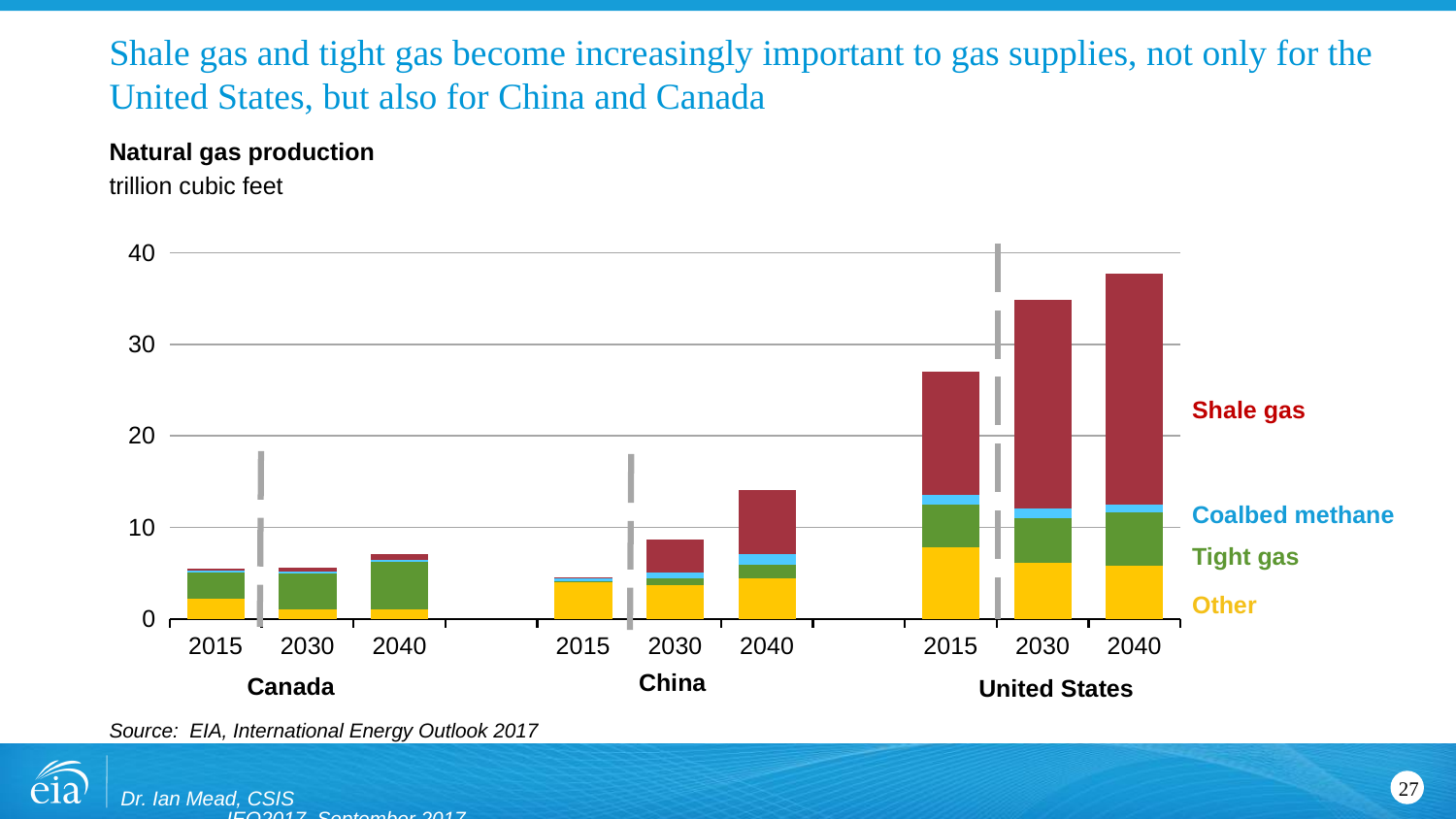
What kind of chart is shown on the slide? Stacked bar chart Do the United States totals rise or fall from 2015 to 2040? rise What unit is the natural gas production measured in? trillion cubic feet Is the total for Canada 2040 greater or less than 10? less Which is larger, the total for United States 2015 or the total for China 2040? United States 2015 Which bar has the highest total natural gas production? United States 2040 Is the total for China 2040 greater or less than 10? greater How many series does the legend list? 4 Is the total for United States 2015 greater or less than 30? less How many bars are plotted in the chart? 9 Which is larger, the total for Canada 2040 or the total for China 2040? China 2040